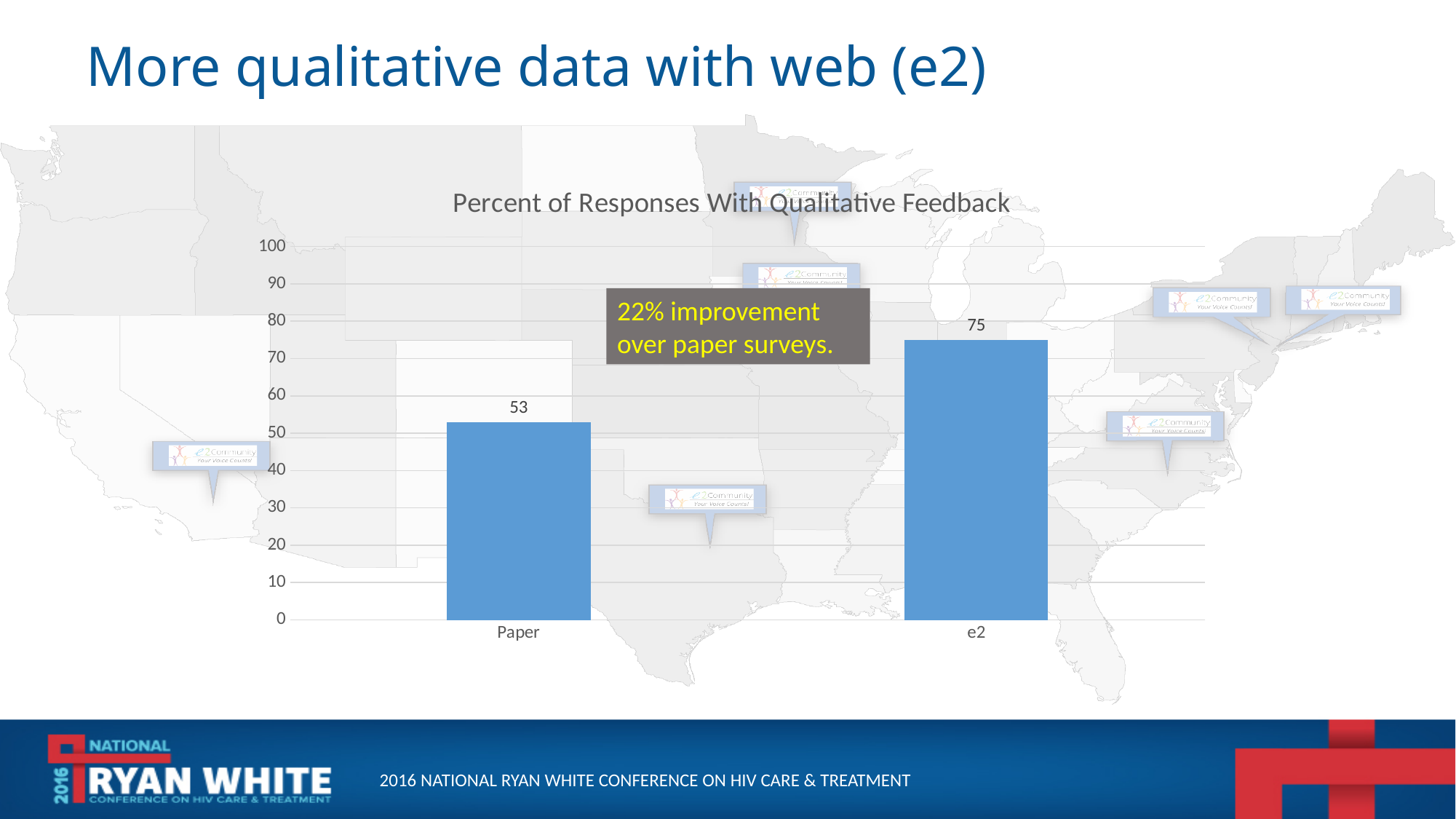
What is the value for Paper? 53 What is the value for e2? 75 Is the value for e2 greater or less than 70? greater What is the maximum value shown on the vertical axis? 100 Which category has the highest value? e2 Which category has the lowest value? Paper How many categories are shown in the chart? 2 What kind of chart is shown on the slide? bar chart What is the title of the chart? Percent of Responses With Qualitative Feedback Which is larger, the value for Paper or the value for e2? e2 Is the value for Paper greater or less than 60? less What is the difference between the values for e2 and Paper? 22